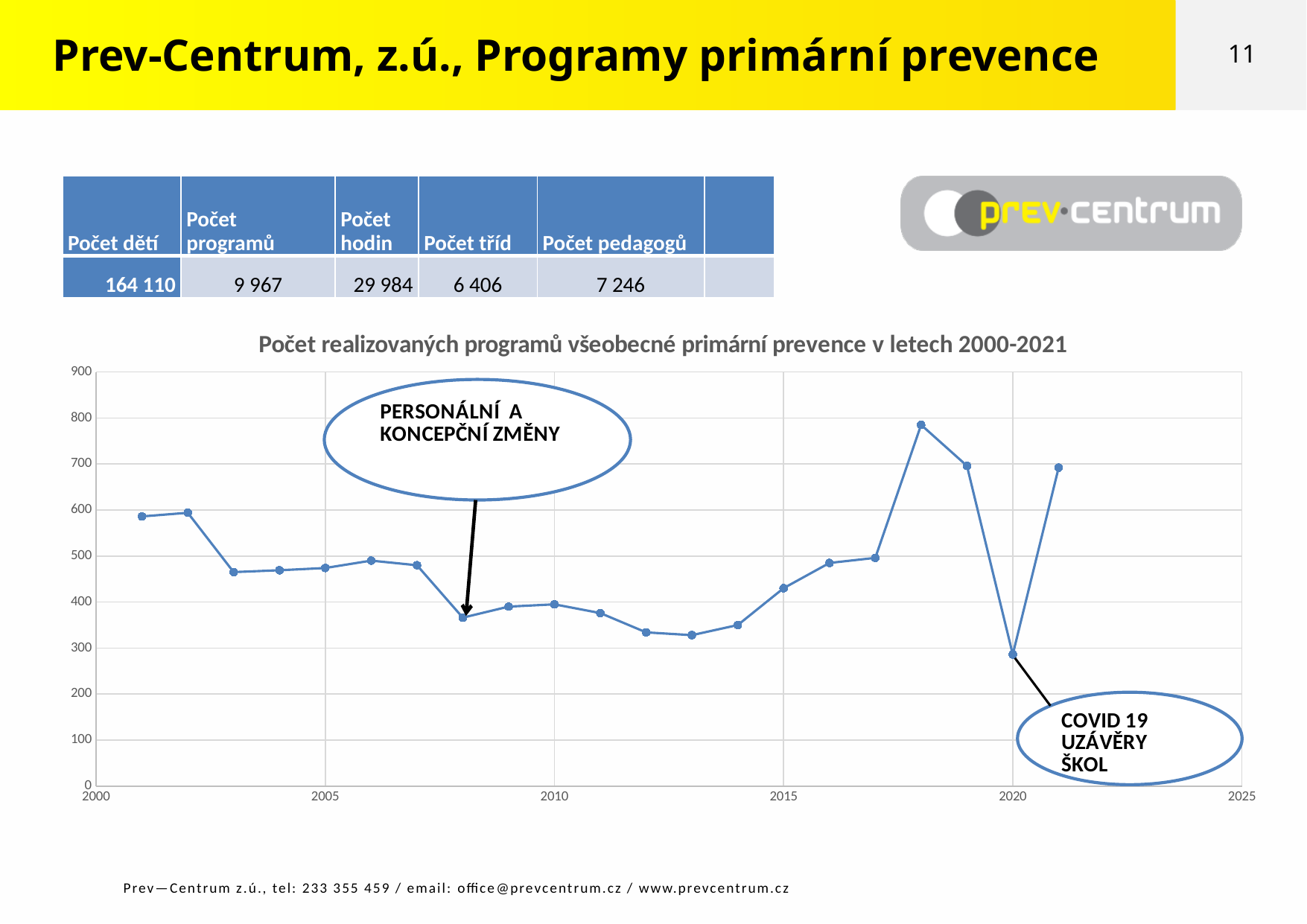
In which year does the line chart reach its highest value? 2018 Is the value for 2001 greater or less than 500? greater Which event does the callout near the 2020 data point attribute the drop to? COVID 19 UZÁVĚRY ŠKOL Which year has the larger value, 2018 or 2019? 2018 Do the values rise or fall between 2013 and 2018? rise In which year does the line chart reach its lowest value? 2020 Is the value for 2018 greater or less than 700? greater What is the title of the chart? Počet realizovaných programů všeobecné primární prevence v letech 2000-2021 What kind of chart is shown on the slide? line chart How many data points are plotted on the line chart? 21 Is the value for 2013 greater or less than 400? less